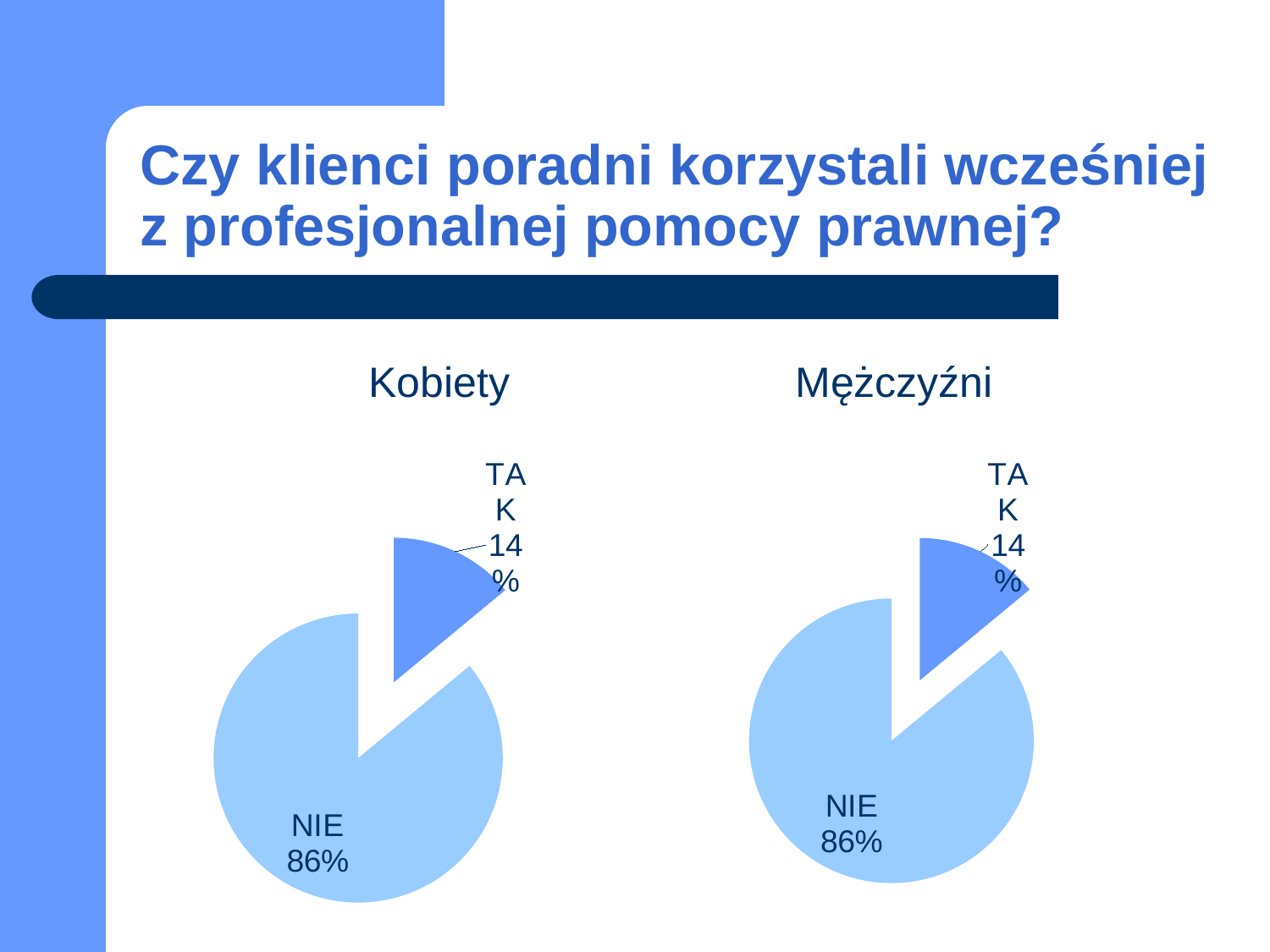
How many slices does the Mężczyźni pie chart have? 2 On the Kobiety chart, what percentage is shown for NIE? 86% What type of chart is the Kobiety chart? Pie chart On the Kobiety chart, which slice is the largest? NIE What is the title of the chart on the right? Mężczyźni On the Kobiety chart, what is the difference between the NIE and TAK percentages? 72% On the Kobiety chart, what percentage is shown for TAK? 14% How many pie charts are on the slide? 2 On the Mężczyźni chart, which slice is the smallest? TAK On the Mężczyźni chart, what percentage is shown for NIE? 86% On the Mężczyźni chart, which is larger, NIE or TAK? NIE On the Mężczyźni chart, what percentage is shown for TAK? 14%